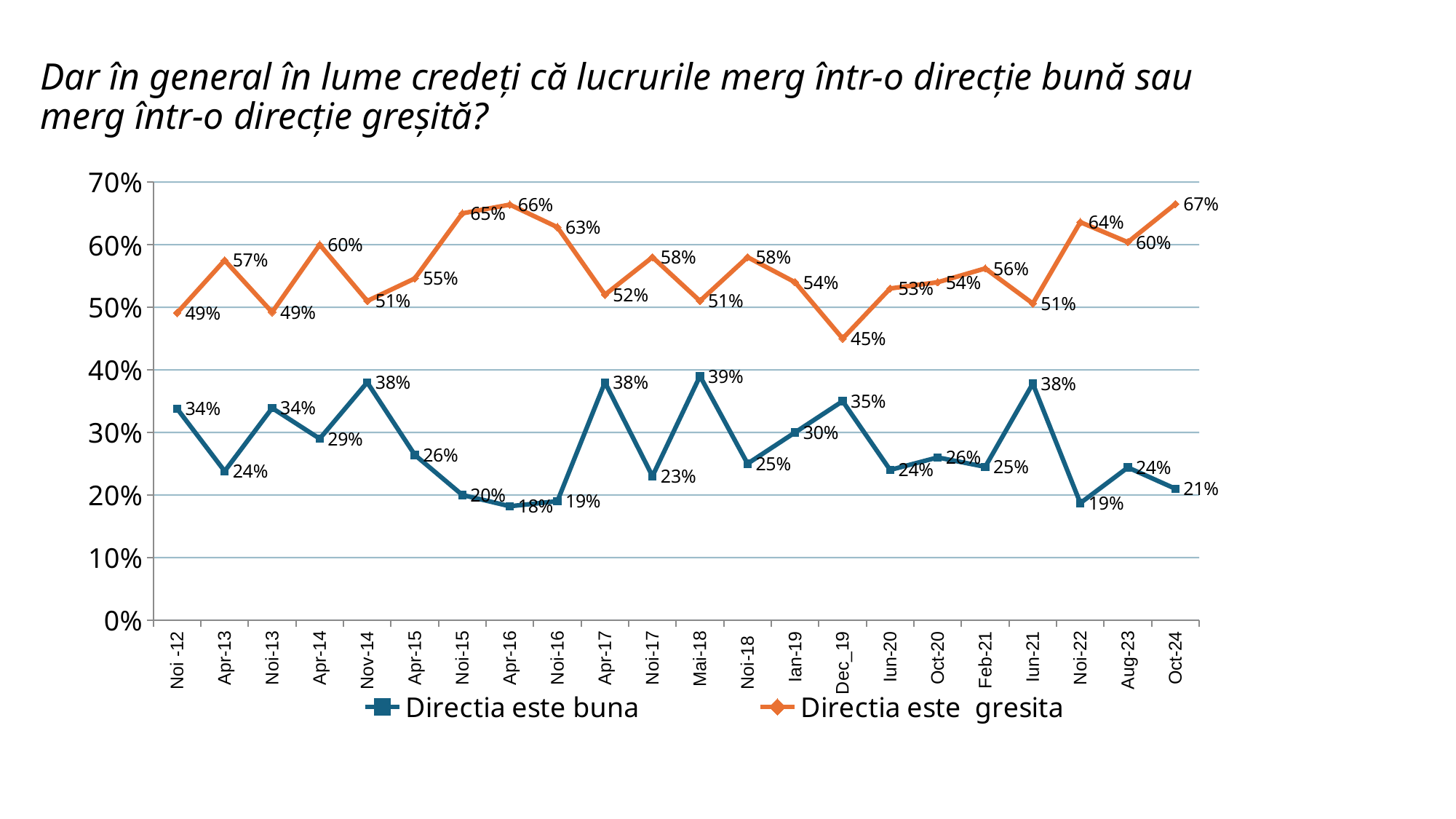
What is the value for 'Directia este buna' in Apr-16? 18% What type of chart is shown on the slide? line chart What is the value for 'Directia este gresita' in Oct-24? 67% How many time points are plotted along the x axis? 22 What is the difference between 'Directia este gresita' and 'Directia este buna' in Oct-24? 46% At which time point is 'Directia este gresita' lowest? Dec_19 What is the value for 'Directia este buna' in Mai-18? 39% What colour is the line for 'Directia este gresita'? orange At which time point is 'Directia este gresita' highest? Oct-24 Does 'Directia este buna' rise or fall from Iun-21 to Noi-22? fall How many series does the legend list? 2 Which is larger in Dec_19: 'Directia este buna' or 'Directia este gresita'? Directia este gresita